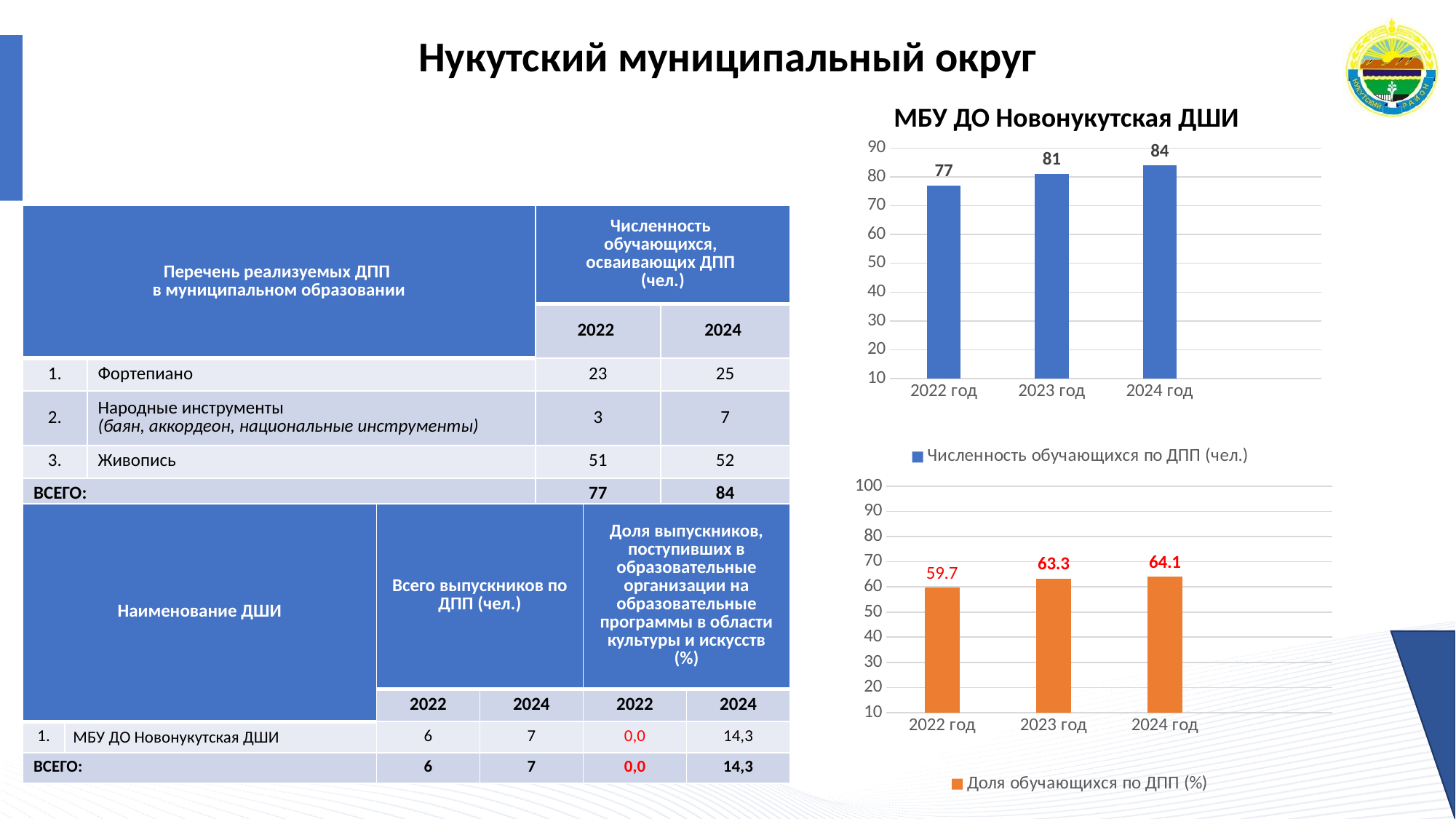
In the top chart titled 'МБУ ДО Новонукутская ДШИ', do the values rise or fall from 2022 год to 2024 год? rise In the top chart titled 'МБУ ДО Новонукутская ДШИ', what is the value for 2024 год? 84 In the bottom chart (orange bars), what is the value for 2022 год? 59.7 In the top chart titled 'МБУ ДО Новонукутская ДШИ', what is the value for 2022 год? 77 In the top chart titled 'МБУ ДО Новонукутская ДШИ', which year has the highest value? 2024 год In the top chart titled 'МБУ ДО Новонукутская ДШИ', which year has the lowest value? 2022 год In the bottom chart (orange bars), what is the value for 2023 год? 63.3 What kind of chart is the bottom chart with orange bars? bar chart In the bottom chart (orange bars), how many bars are plotted? 3 In the top chart titled 'МБУ ДО Новонукутская ДШИ', what is the difference between the values for 2024 год and 2022 год? 7 What is the legend entry of the bottom chart with orange bars? Доля обучающихся по ДПП (%) In the bottom chart (orange bars), which is larger: the value for 2023 год or the value for 2022 год? 2023 год